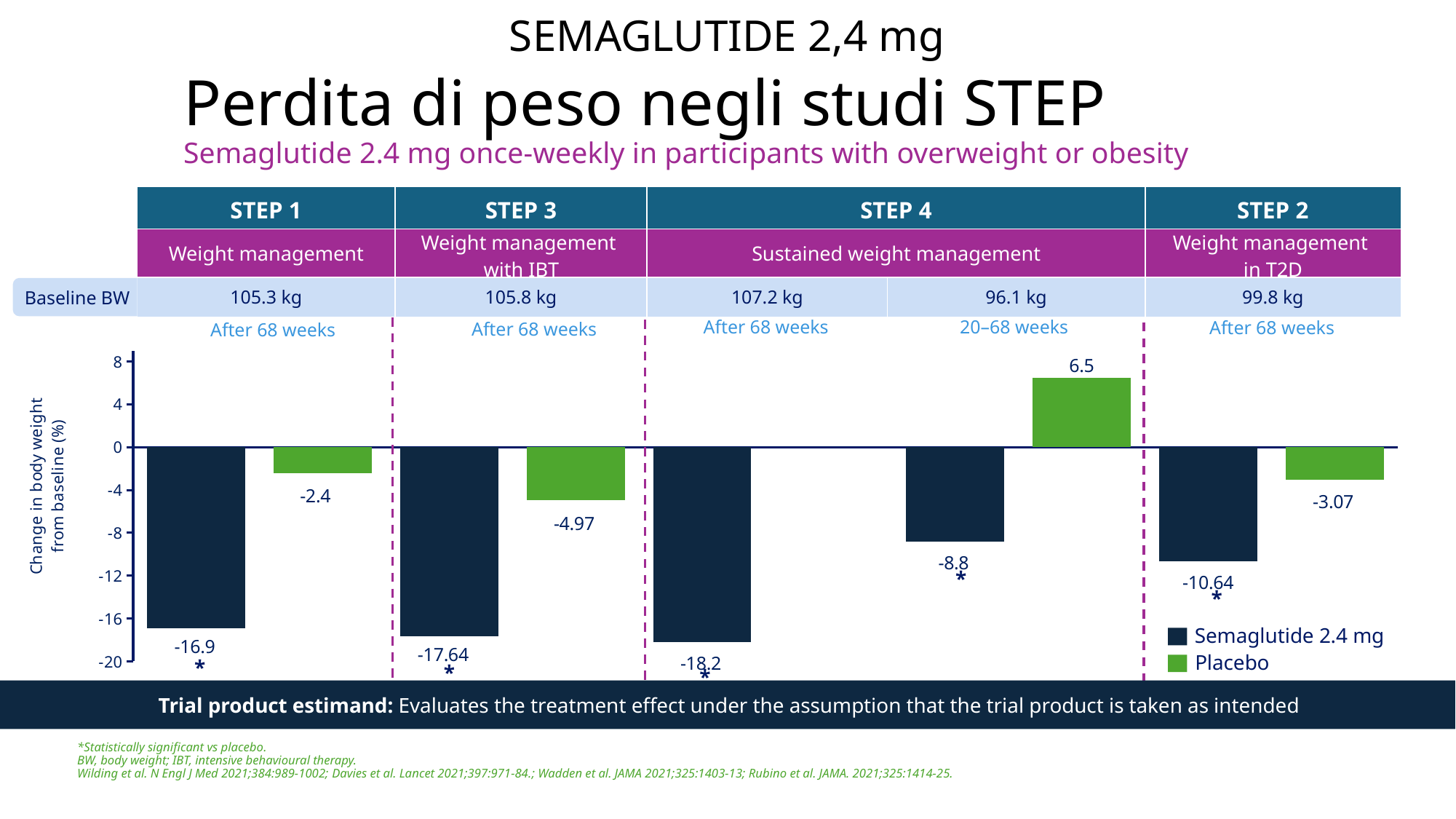
What is the change in body weight for Semaglutide 2.4 mg in STEP 4 after 68 weeks? -18.2 What kind of chart is shown on the slide? Bar chart In STEP 1, what is the difference between the Semaglutide 2.4 mg and Placebo changes in body weight? 14.5 What is the change in body weight for Semaglutide 2.4 mg in STEP 2 after 68 weeks? -10.64 What is the change in body weight for Placebo in STEP 3 after 68 weeks? -4.97 What is the change in body weight for Placebo in STEP 4 over 20–68 weeks? 6.5 Which bar shows the lowest value (greatest weight reduction) on the chart? Semaglutide 2.4 mg, STEP 4 after 68 weeks (-18.2) How many series does the legend list? 2 Which bar shows the highest value on the chart? Placebo, STEP 4 20–68 weeks (6.5) Which shows a larger weight reduction for Semaglutide 2.4 mg after 68 weeks: STEP 1 or STEP 3? STEP 3 In STEP 2, what is the difference between the Semaglutide 2.4 mg and Placebo changes in body weight? 7.57 What is the change in body weight for Semaglutide 2.4 mg in STEP 1 after 68 weeks? -16.9